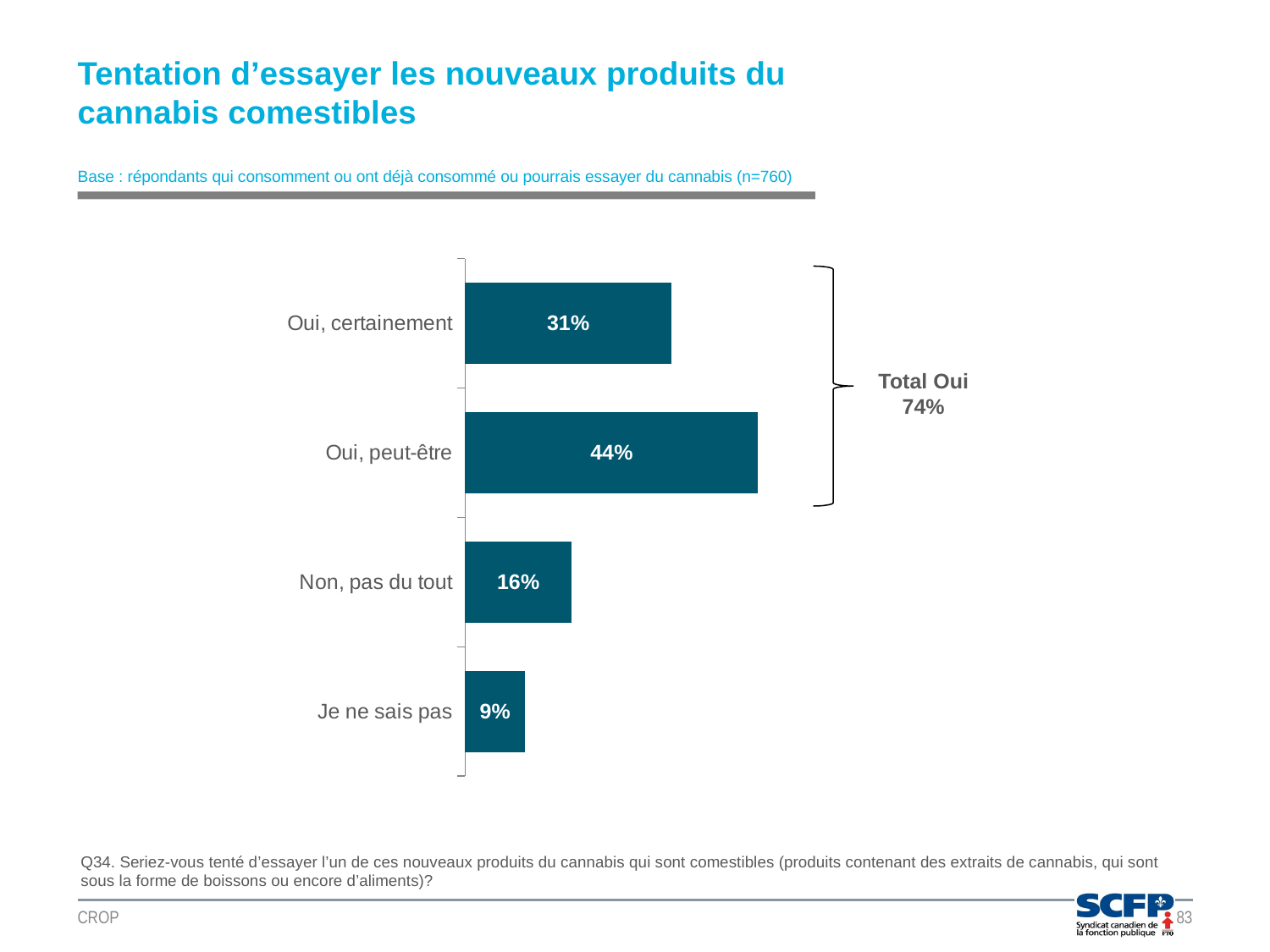
How many categories are shown in the chart? 4 What is the value for "Oui, peut-être"? 44% Which category has the lowest value? Je ne sais pas What is the "Total Oui" value shown next to the bracket on the chart? 74% Which category has the highest value? Oui, peut-être What is the difference between "Oui, peut-être" and "Oui, certainement"? 13% What is the value for "Non, pas du tout"? 16% What kind of chart is shown on the slide? Bar chart What is the value for "Je ne sais pas"? 9% What is the difference between "Non, pas du tout" and "Je ne sais pas"? 7% Which is larger, "Oui, certainement" or "Non, pas du tout"? Oui, certainement What is the value for "Oui, certainement"? 31%